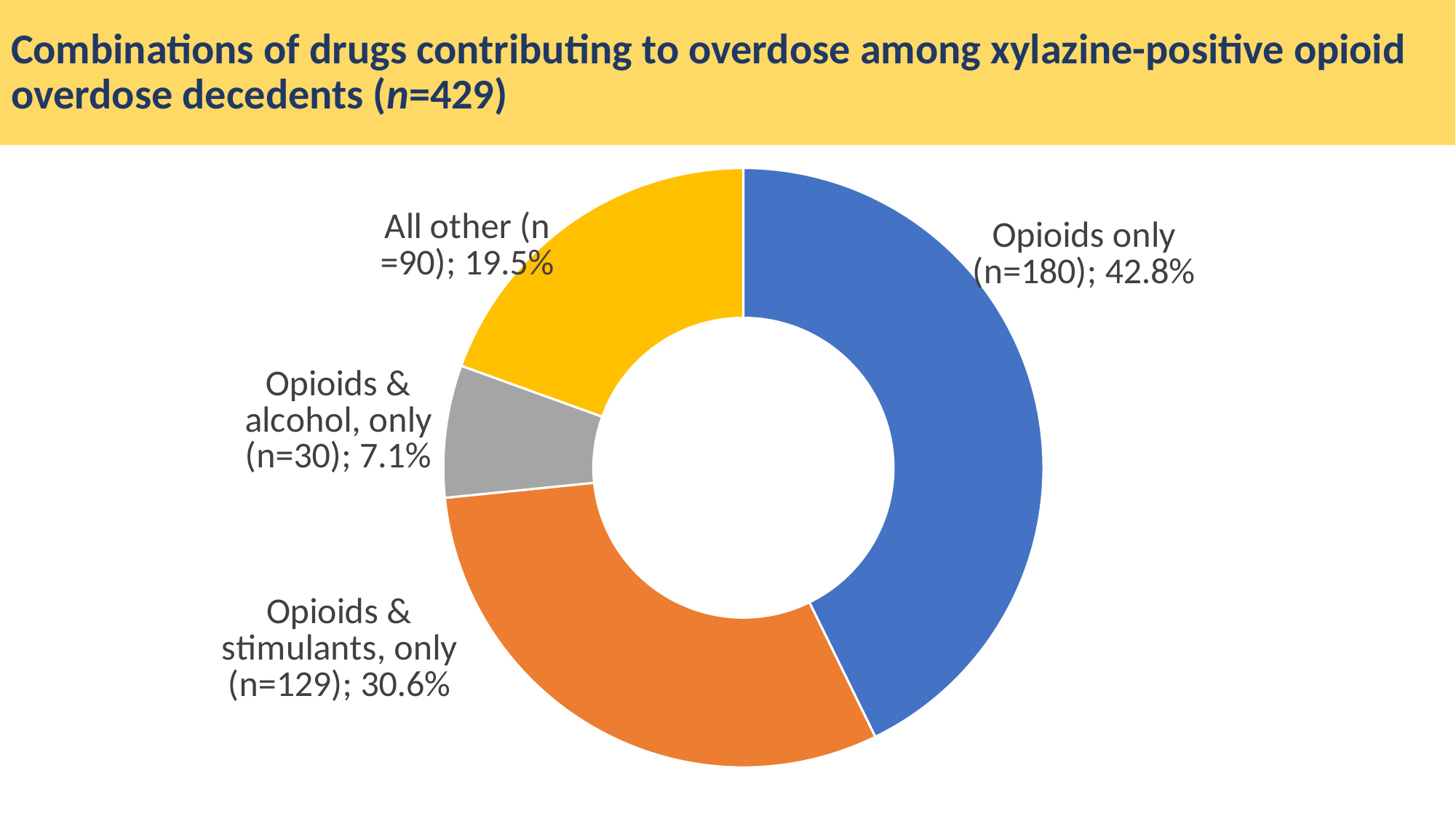
What is the total number of decedents (n) stated in the chart title? 429 How many categories are shown in the chart? 4 Which has a larger share: 'All other' or 'Opioids & alcohol, only'? All other How many decedents are in the 'Opioids & stimulants, only' category? 129 Which drug combination category has the smallest share of the pie? Opioids & alcohol, only What percentage of xylazine-positive opioid overdose decedents had opioids only contributing to overdose? 42.8% What kind of chart is shown on the slide? Pie chart (doughnut) What is the difference in number of decedents between 'Opioids only' and 'Opioids & stimulants, only'? 51 What colour is the 'Opioids & stimulants, only' slice? Orange What percentage share does the 'Opioids & alcohol, only' slice represent? 7.1% Which drug combination category has the largest share of the pie? Opioids only How many decedents fall into the 'All other' category? 90